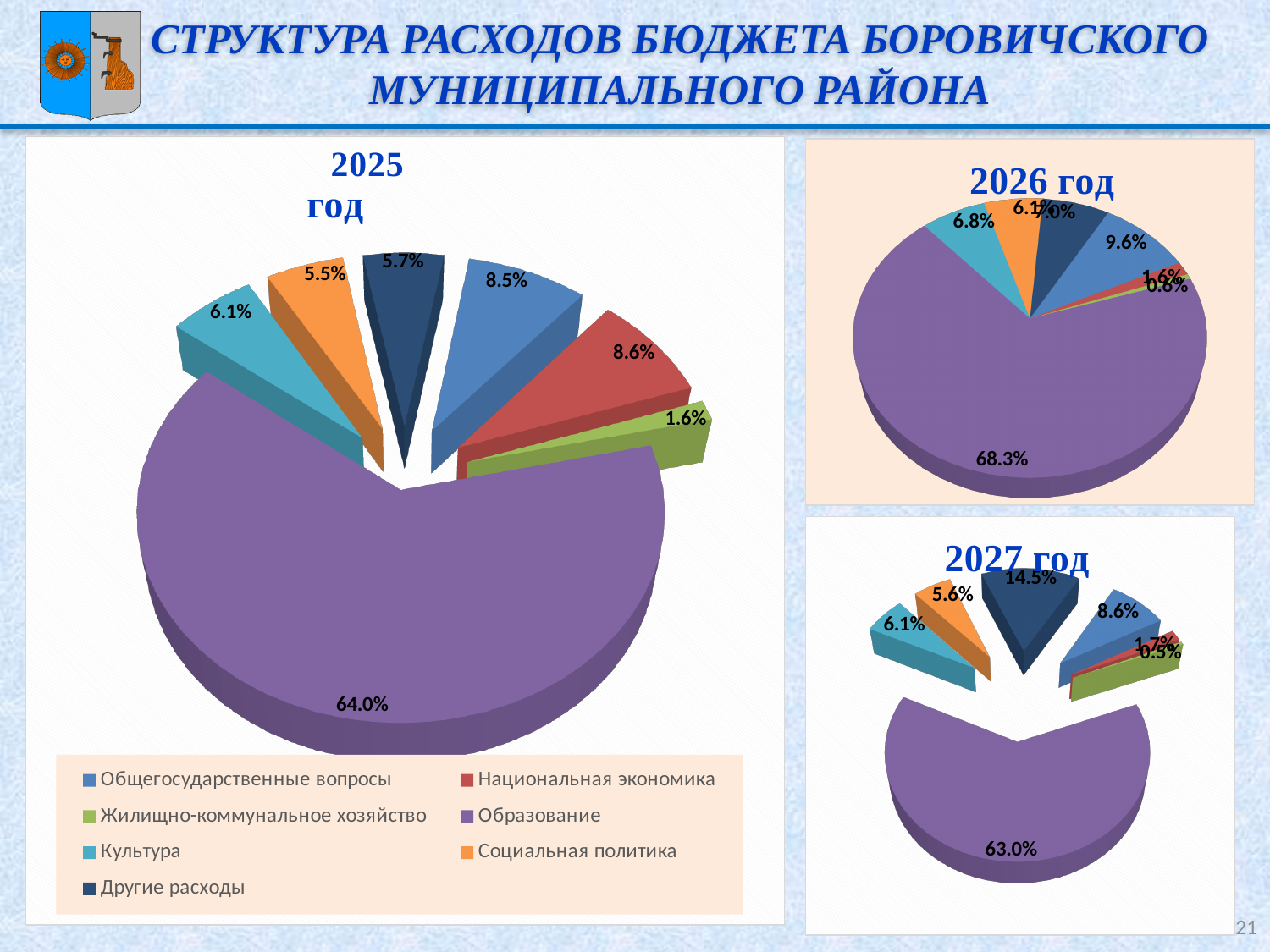
In the 2026 год chart, which is larger: Культура or Социальная политика? Культура In the 2025 год chart, what share does Культура have? 6.1% In the 2027 год chart, what share does Другие расходы have? 14.5% What type of chart is used for the 2025 год data? Pie chart In the 2026 год chart, what share does Общегосударственные вопросы have? 9.6% How many categories does the legend list? 7 In the 2025 год chart, what share does Национальная экономика have? 8.6% In the 2025 год chart, which category has the largest share? Образование In the 2025 год chart, what share does Образование have? 64.0% In the 2025 год chart, what is the difference between the shares of Общегосударственные вопросы and Социальная политика? 3.0% In the 2026 год chart, what share does Образование have? 68.3% In the 2027 год chart, what share does Образование have? 63.0%